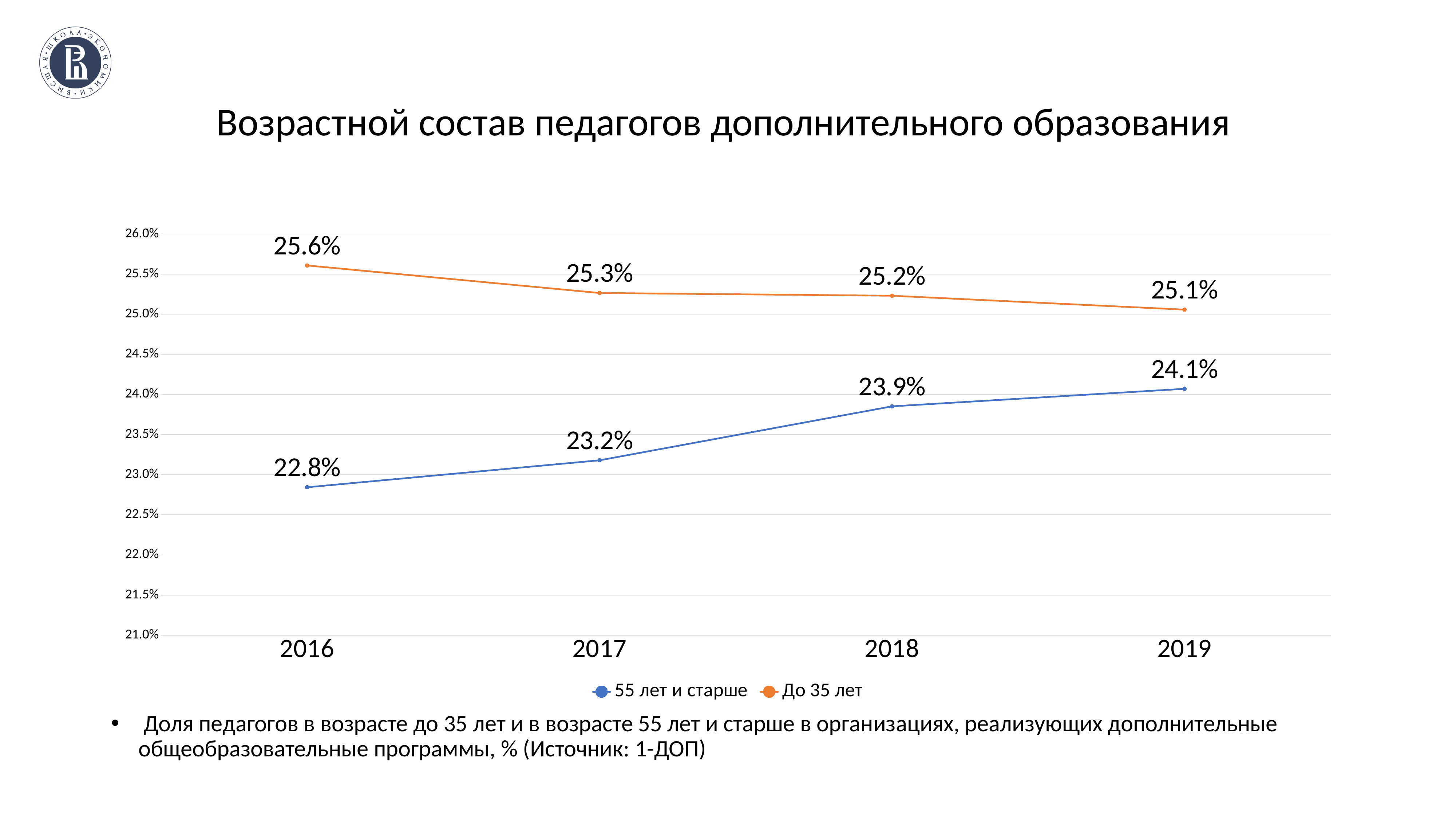
Does the "55 лет и старше" series rise or fall from 2016 to 2019? Rise What is the difference between the "До 35 лет" and "55 лет и старше" values in 2016? 2.8% What is the difference between the "55 лет и старше" values in 2019 and 2016? 1.3% How many series does the legend list? 2 In which year is the "55 лет и старше" series lowest? 2016 Which series has the larger value in 2019, "55 лет и старше" or "До 35 лет"? До 35 лет How many years are shown on the x axis? 4 In which year is the "До 35 лет" series highest? 2016 What kind of chart is shown on the slide? Line chart What is the value for "55 лет и старше" in 2018? 23.9% What is the value for "До 35 лет" in 2019? 25.1% What is the value for "55 лет и старше" in 2016? 22.8%